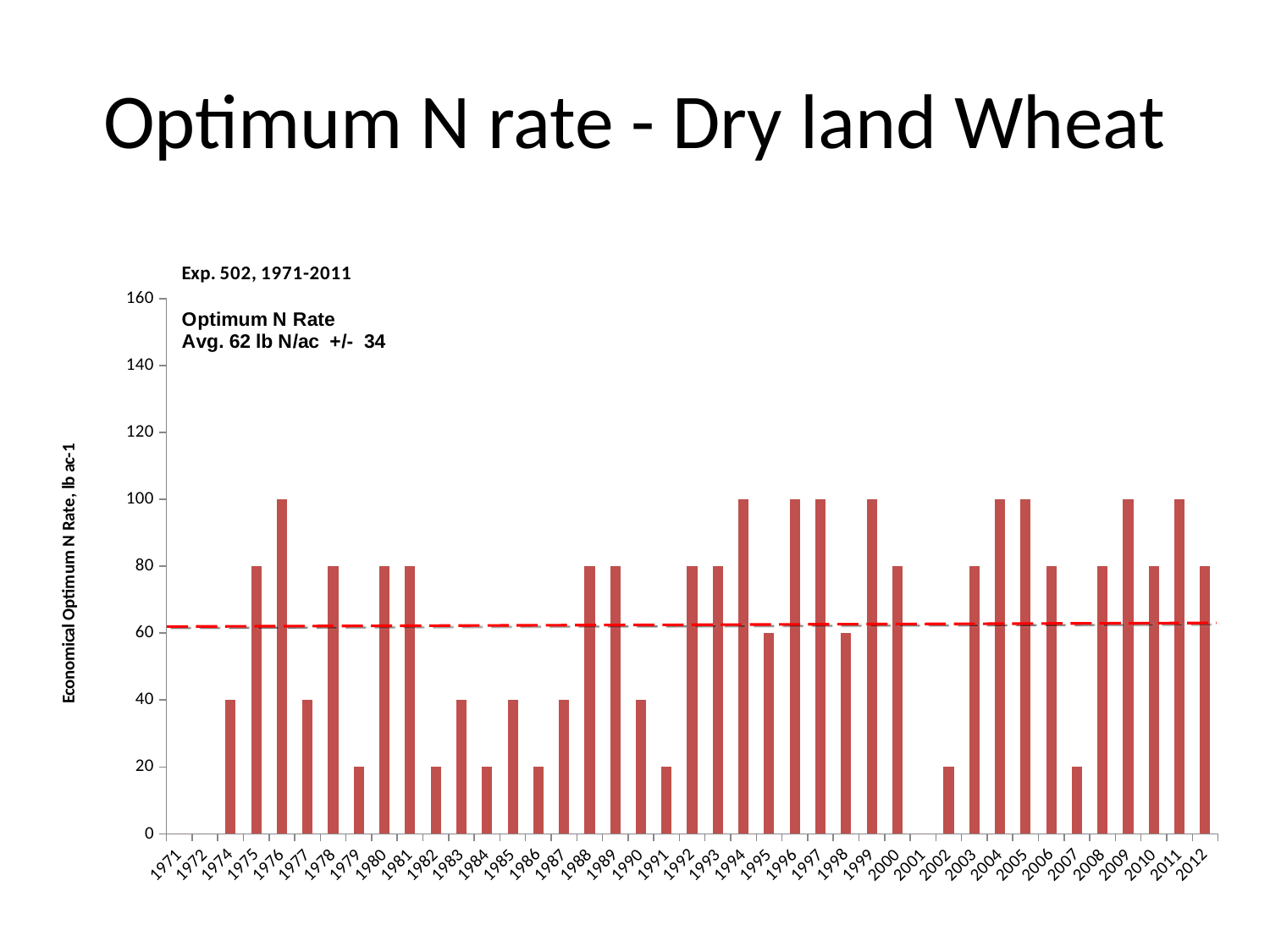
What is the Economical Optimum N Rate for 1995? 60 What is the highest value reached by any bar on the chart? 100 What kind of chart is shown on the slide? bar chart What is the Economical Optimum N Rate for 1976? 100 What is the difference between the values for 1976 and 1979? 80 What is the Economical Optimum N Rate for 2012? 80 What average Optimum N Rate is stated in the chart's text box? 62 lb N/ac +/- 34 What is the Economical Optimum N Rate for 1979? 20 Is the value for 2007 greater or less than 40? less Is the value for 2004 greater or less than 60? greater Which year has the larger value, 1994 or 1998? 1994 What experiment label appears at the top of the chart? Exp. 502, 1971-2011